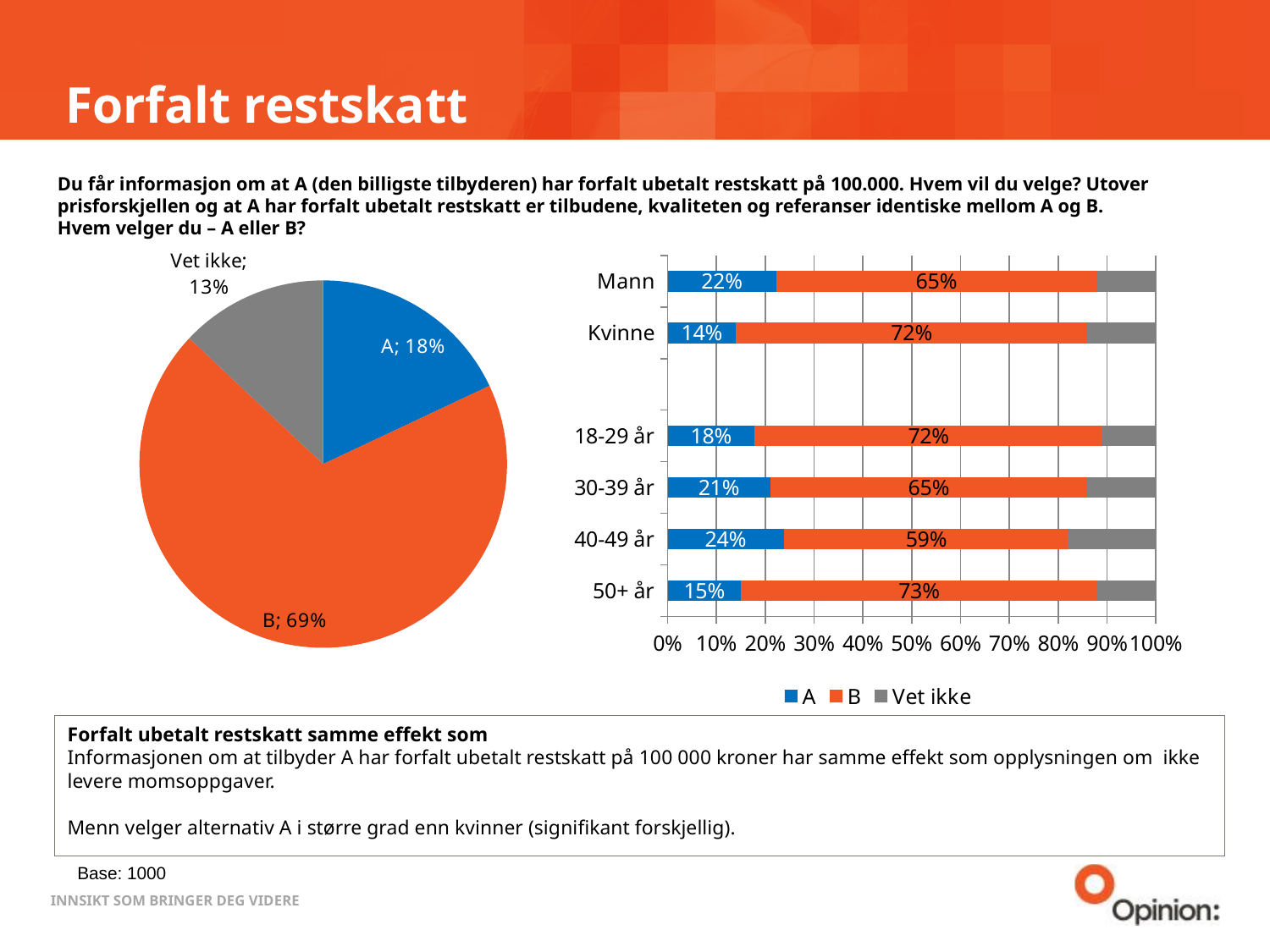
In the pie chart on the left, what share of respondents chose B? 69% In the pie chart on the left, what share of respondents answered 'Vet ikke'? 13% In the bar chart on the right, what is the value of A for Mann? 22% In the pie chart on the left, which slice is the largest? B In the bar chart on the right, how many series does the legend list? 3 What type of chart is shown on the right side of the slide? Stacked bar chart In the bar chart on the right, what is the value of B for 50+ år? 73% In the pie chart on the left, how many percentage points larger is the B slice than the A slice? 51 In the bar chart on the right, which category has the lowest value for B? 40-49 år In the bar chart on the right, which category has the highest value for A? 40-49 år In the bar chart on the right, what is the difference in the A value between Mann and Kvinne? 8 percentage points In the pie chart on the left, which slice is the smallest? Vet ikke